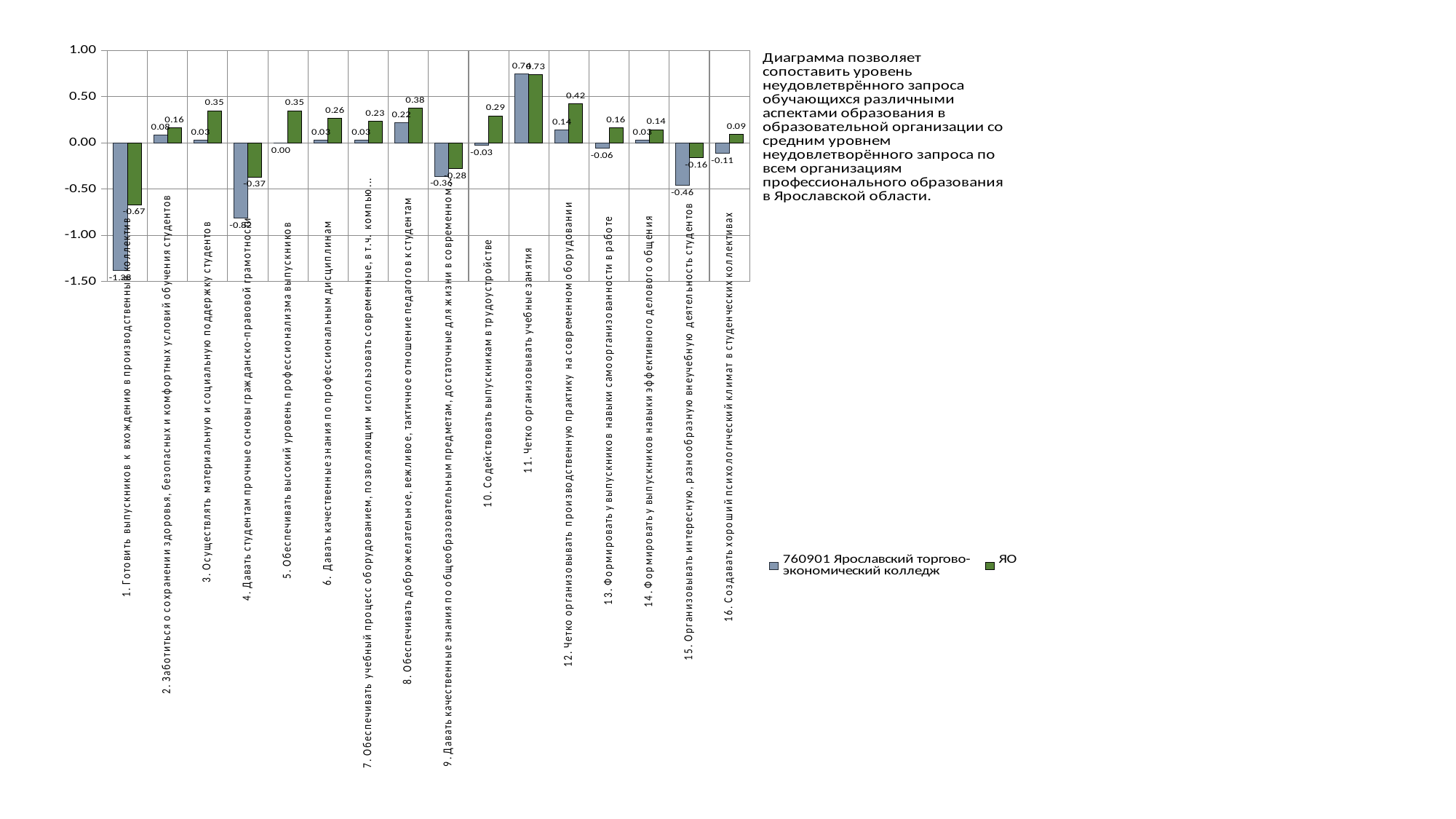
How many series does the legend list? 2 What is the value for ЯО for category 1 (Готовить выпускников к вхождению в производственные коллективы)? -0.67 Which category has the lowest value for the ЯО series? 1. Готовить выпускников к вхождению в производственные коллективы Is the value for 760901 Ярославский торгово-экономический колледж for category 1 greater or less than -1.00? less For category 9 (Давать качественные знания по общеобразовательным предметам), which series has the larger value: 760901 Ярославский торгово-экономический колледж or ЯО? ЯО Which category has the highest value for the ЯО series? 11. Четко организовывать учебные занятия What kind of chart is shown on the slide? bar chart Which series is shown in green in the legend? ЯО What is the value for ЯО for category 12 (Четко организовывать производственную практику на современном оборудовании)? 0.42 What is the value for 760901 Ярославский торгово-экономический колледж for category 15 (Организовывать интересную, разнообразную внеучебную деятельность студентов)? -0.46 For category 12, what is the difference between the ЯО value and the 760901 Ярославский торгово-экономический колледж value? 0.28 How many categories are shown on the x axis of the chart? 16